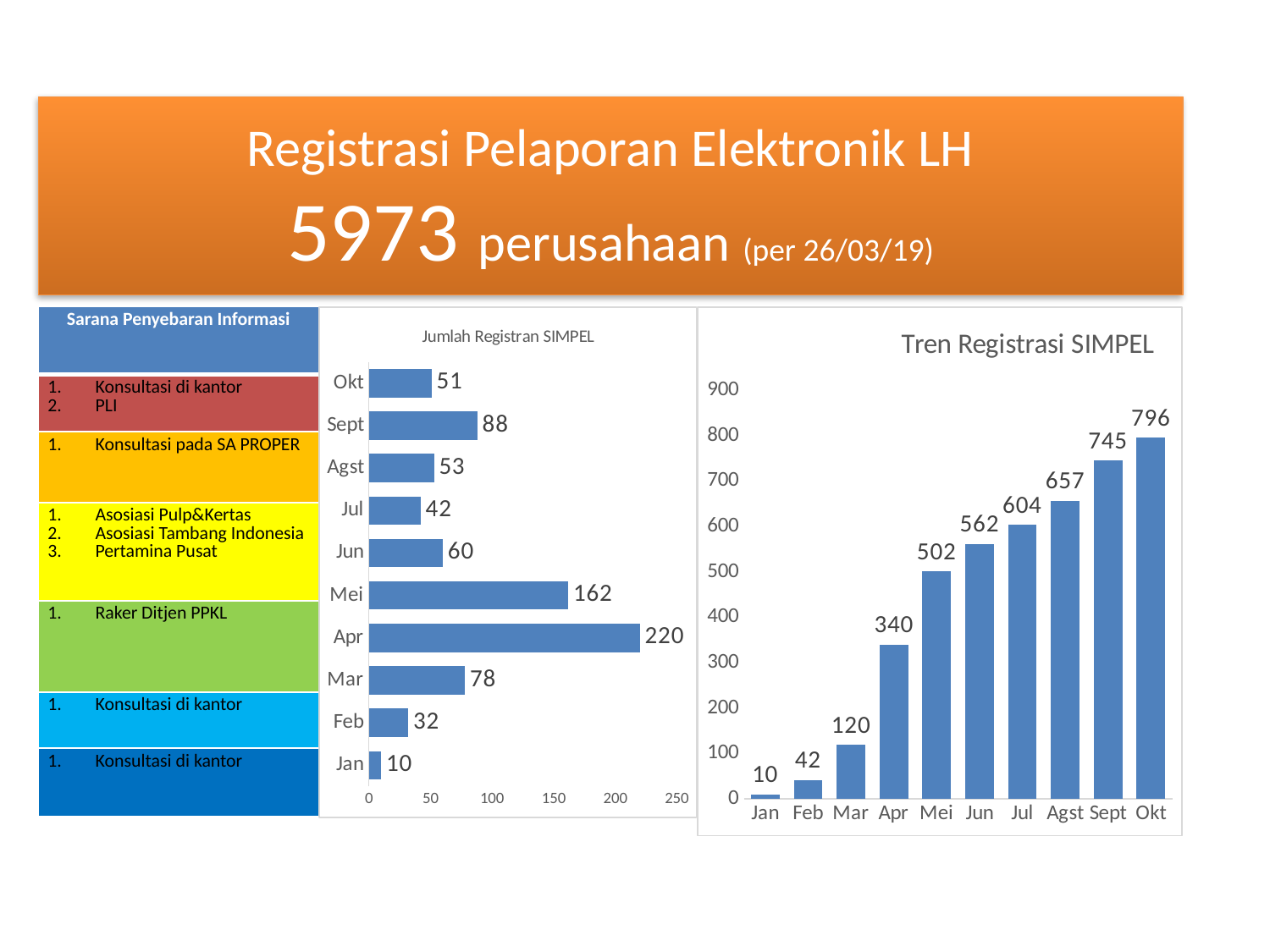
In the 'Jumlah Registran SIMPEL' chart, which month has the highest value? Apr What is the title of the chart on the right side of the slide? Tren Registrasi SIMPEL In the 'Tren Registrasi SIMPEL' chart, do the values rise or fall from Jan to Okt? Rise In the 'Tren Registrasi SIMPEL' chart, what is the difference between the values for Apr and Mar? 220 In the 'Jumlah Registran SIMPEL' chart, which is larger, the value for Sept or the value for Agst? Sept What kind of chart is 'Jumlah Registran SIMPEL'? Bar chart In the 'Tren Registrasi SIMPEL' chart, what is the value for Jun? 562 In the 'Jumlah Registran SIMPEL' chart, which month has the lowest value? Jan In the 'Tren Registrasi SIMPEL' chart, what is the value for Okt? 796 In the 'Jumlah Registran SIMPEL' chart, how many months are plotted? 10 In the 'Jumlah Registran SIMPEL' chart, what is the difference between the values for Mei and Mar? 84 In the 'Jumlah Registran SIMPEL' chart, what is the value for Apr? 220